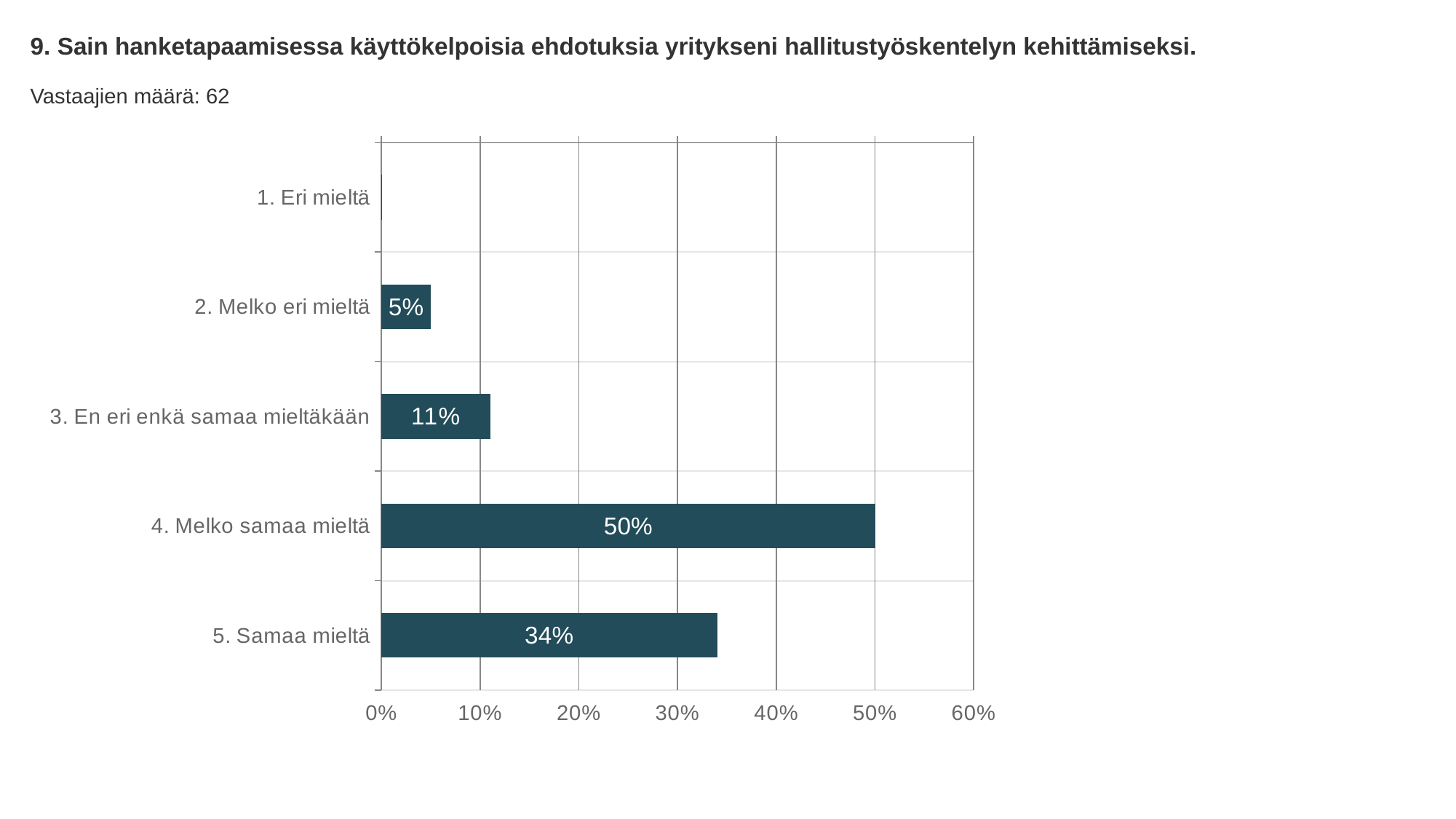
What is the difference in percentage points between "4. Melko samaa mieltä" and "5. Samaa mieltä"? 16 percentage points Which response option has the lowest percentage? 1. Eri mieltä How many response categories are shown in the chart? 5 What percentage of respondents chose "5. Samaa mieltä"? 34% What percentage of respondents chose "3. En eri enkä samaa mieltäkään"? 11% What percentage of respondents chose "4. Melko samaa mieltä"? 50% What kind of chart is shown on the slide? Bar chart Is the value for "5. Samaa mieltä" greater or less than 40%? less How many respondents (Vastaajien määrä) are reported on the slide? 62 Which has a larger share, "3. En eri enkä samaa mieltäkään" or "2. Melko eri mieltä"? 3. En eri enkä samaa mieltäkään What percentage of respondents chose "2. Melko eri mieltä"? 5% Which response option has the highest percentage? 4. Melko samaa mieltä